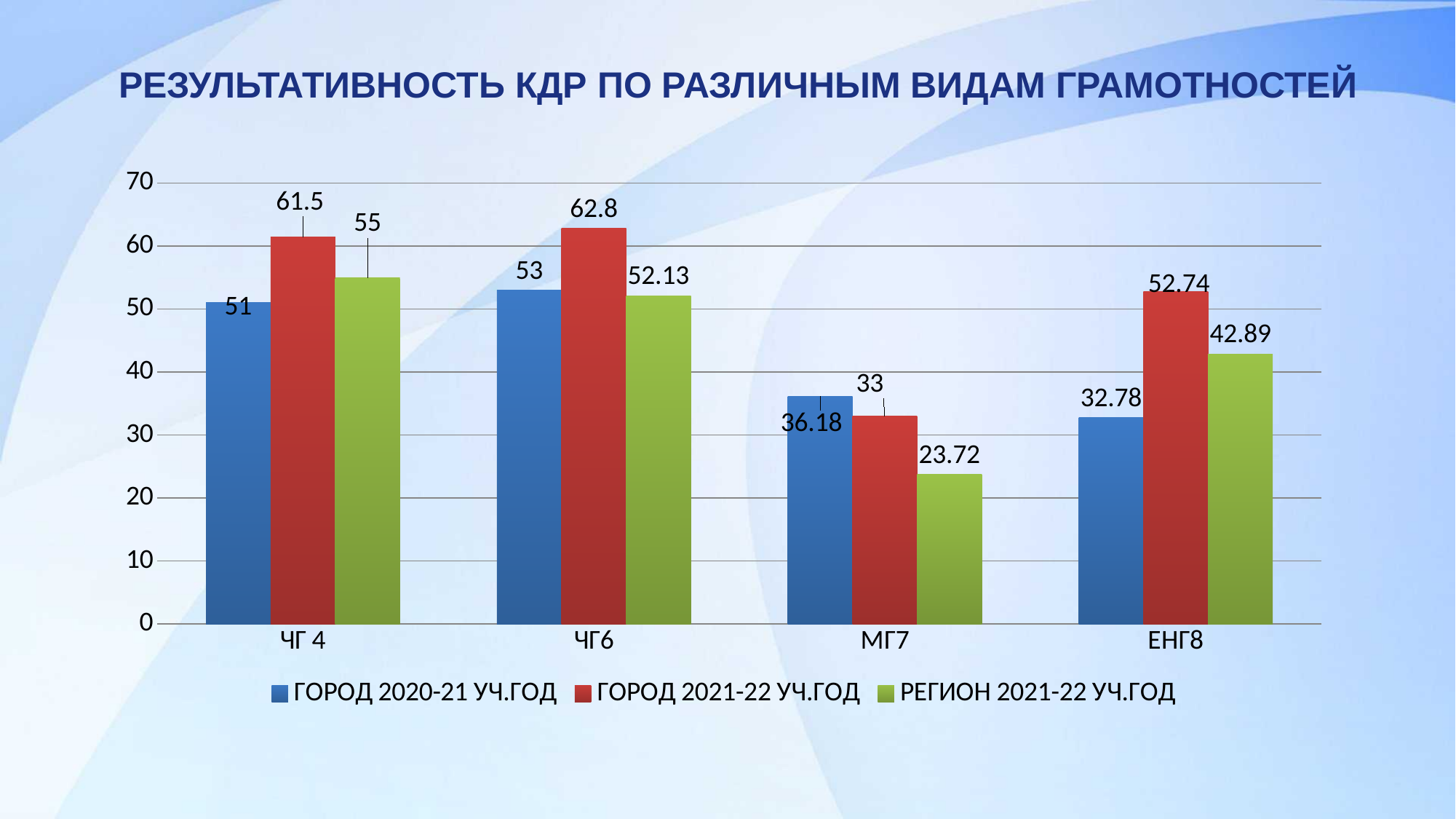
Is the value for РЕГИОН 2021-22 УЧ.ГОД in the ЕНГ8 category greater or less than 40? greater Which category has the lowest value for РЕГИОН 2021-22 УЧ.ГОД? МГ7 How many categories are shown on the x axis? 4 In the МГ7 category, which is larger: ГОРОД 2020-21 УЧ.ГОД or ГОРОД 2021-22 УЧ.ГОД? ГОРОД 2020-21 УЧ.ГОД What is the value for ГОРОД 2020-21 УЧ.ГОД in the ЕНГ8 category? 32.78 What is the value for РЕГИОН 2021-22 УЧ.ГОД in the МГ7 category? 23.72 What type of chart is shown on the slide? Bar chart What is the difference between the ГОРОД 2021-22 УЧ.ГОД and ГОРОД 2020-21 УЧ.ГОД values in the ЧГ 4 category? 10.5 How many series does the legend list? 3 What is the value for ГОРОД 2021-22 УЧ.ГОД in the ЧГ6 category? 62.8 What is the title of the chart? РЕЗУЛЬТАТИВНОСТЬ КДР ПО РАЗЛИЧНЫМ ВИДАМ ГРАМОТНОСТЕЙ Which category has the highest value for ГОРОД 2021-22 УЧ.ГОД? ЧГ6